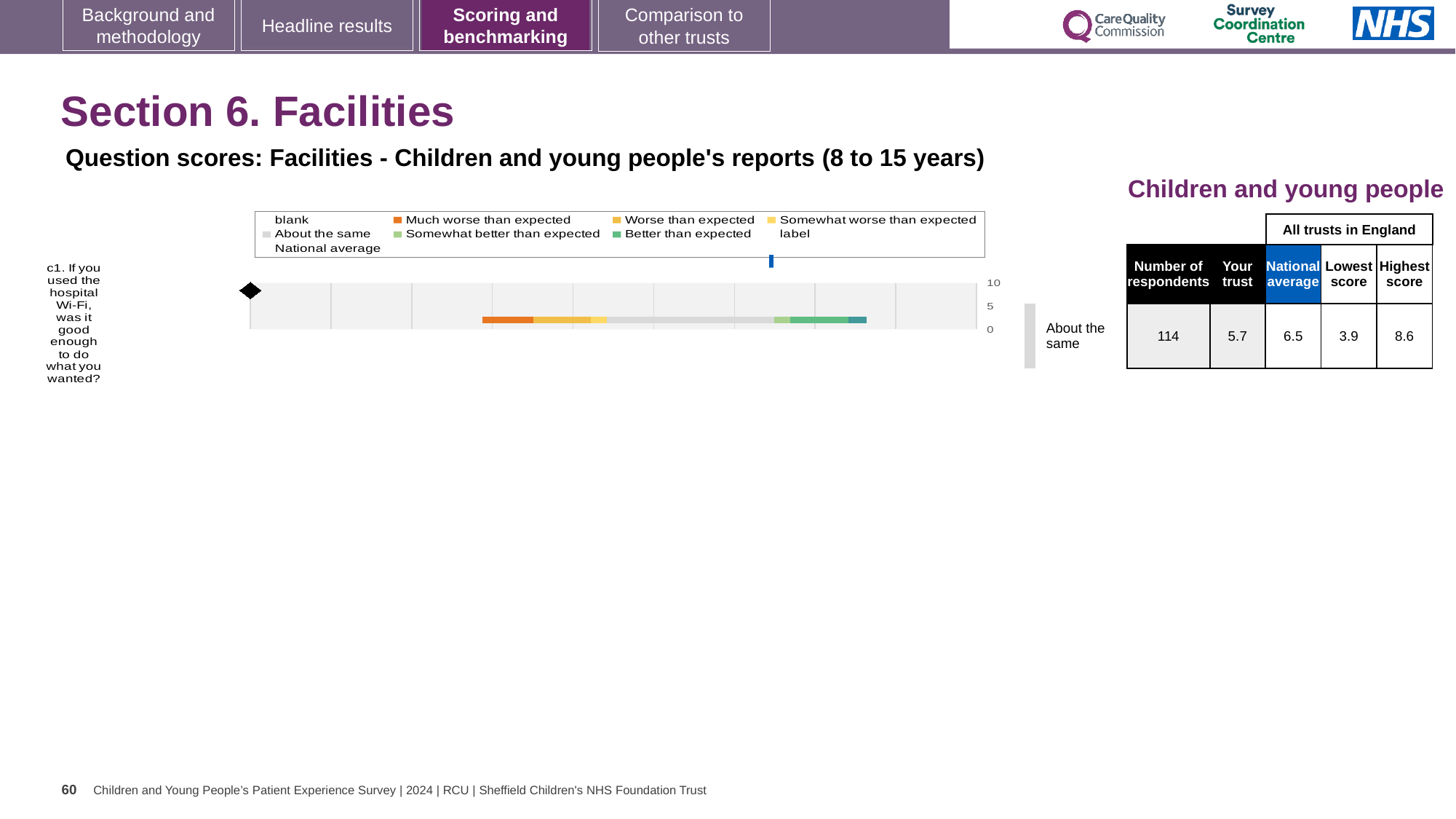
Which legend entry is shown in orange? Much worse than expected Which is larger for question c1: the 'Your trust' score or the national average? National average What is the lowest score among all trusts in England for question c1? 3.9 What kind of chart is used to show the question score for c1? bar chart What is the difference between the national average and the 'Your trust' score for question c1? 0.8 What is the 'Your trust' score for question c1 about the hospital Wi-Fi? 5.7 What is the national average score for question c1? 6.5 What is the highest score among all trusts in England for question c1? 8.6 What benchmark category is the trust's result for question c1 labelled as? About the same How many respondents answered question c1? 114 What is the difference between the highest score and the lowest score for question c1? 4.7 How many survey questions are plotted on the chart? 1